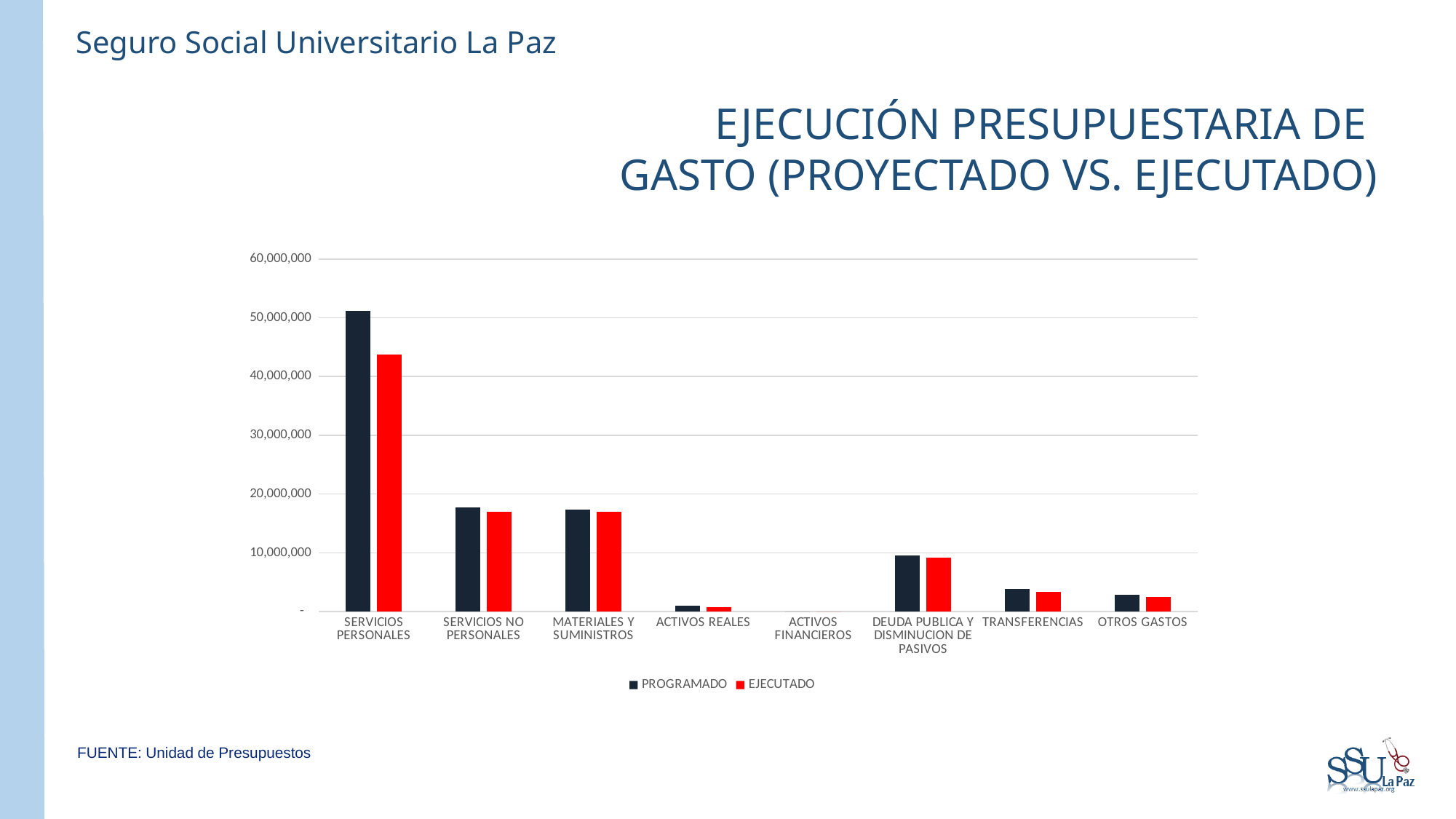
Is the PROGRAMADO value for SERVICIOS NO PERSONALES greater or less than 20,000,000? less For SERVICIOS PERSONALES, which is larger: PROGRAMADO or EJECUTADO? PROGRAMADO How many series does the chart legend list? 2 Is the EJECUTADO value for SERVICIOS PERSONALES greater or less than 40,000,000? greater How many expense categories are shown on the x axis of the chart? 8 Which of the two series is shown in red in the chart? EJECUTADO Is the EJECUTADO value for SERVICIOS PERSONALES greater or less than 50,000,000? less Which category has the lowest EJECUTADO value? ACTIVOS FINANCIEROS What kind of chart is shown on the slide? bar chart Which category has the highest PROGRAMADO value? SERVICIOS PERSONALES What is the title of the chart? EJECUCIÓN PRESUPUESTARIA DE GASTO (PROYECTADO VS. EJECUTADO)